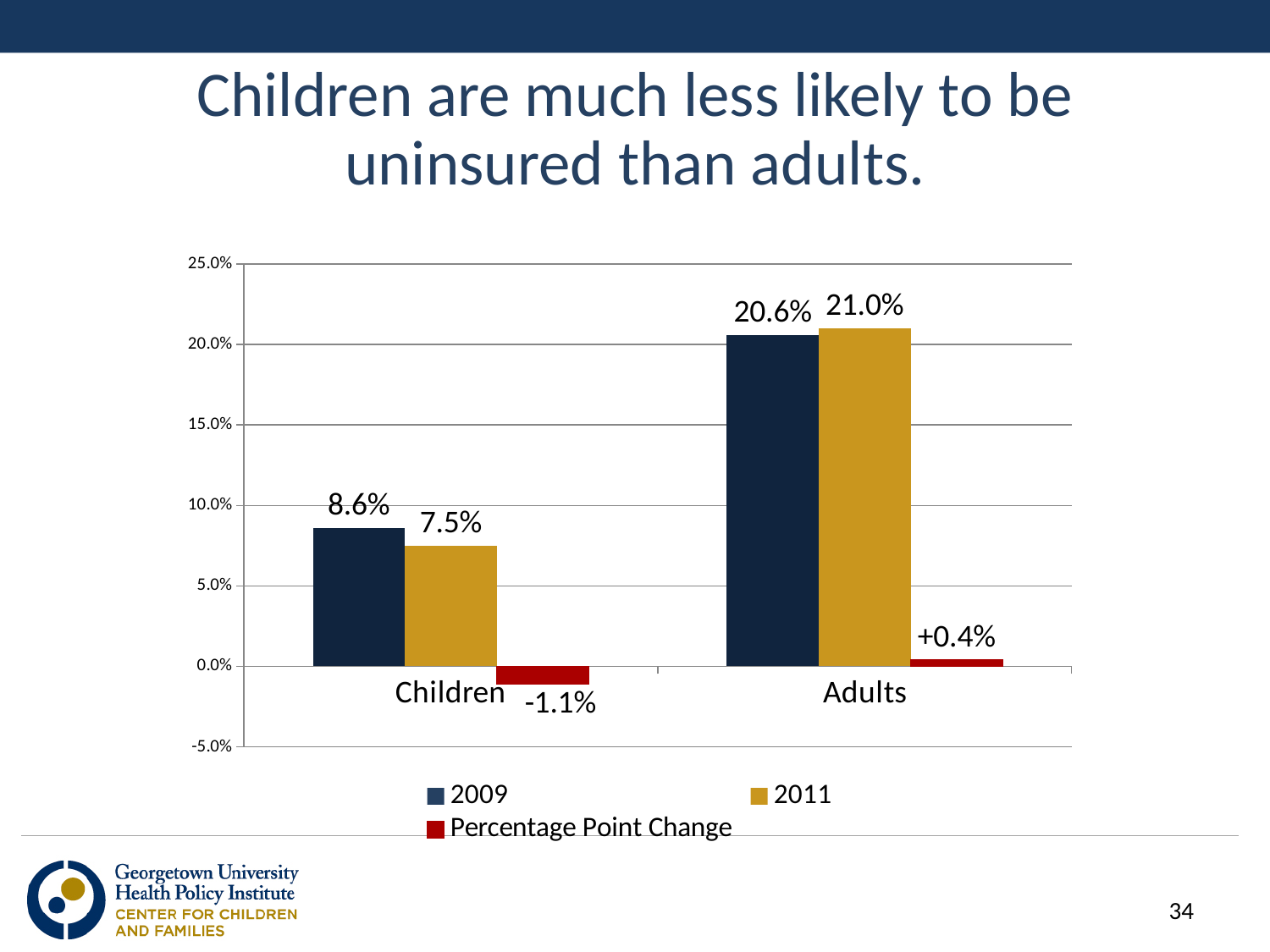
What is the Percentage Point Change shown for Adults? +0.4% Which category has the highest 2011 value? Adults What kind of chart is shown on the slide? bar chart What was the uninsured rate for Children in 2009? 8.6% How many categories are shown on the x axis? 2 Is the 2011 value for Adults greater or less than 20.0%? greater What is the difference between the 2009 values for Adults and Children? 12.0% How many series does the legend list? 3 Which category has the lowest 2009 value? Children What was the uninsured rate for Adults in 2011? 21.0% What is the Percentage Point Change shown for Children? -1.1% Which is larger, the 2009 value for Children or the 2011 value for Children? 2009